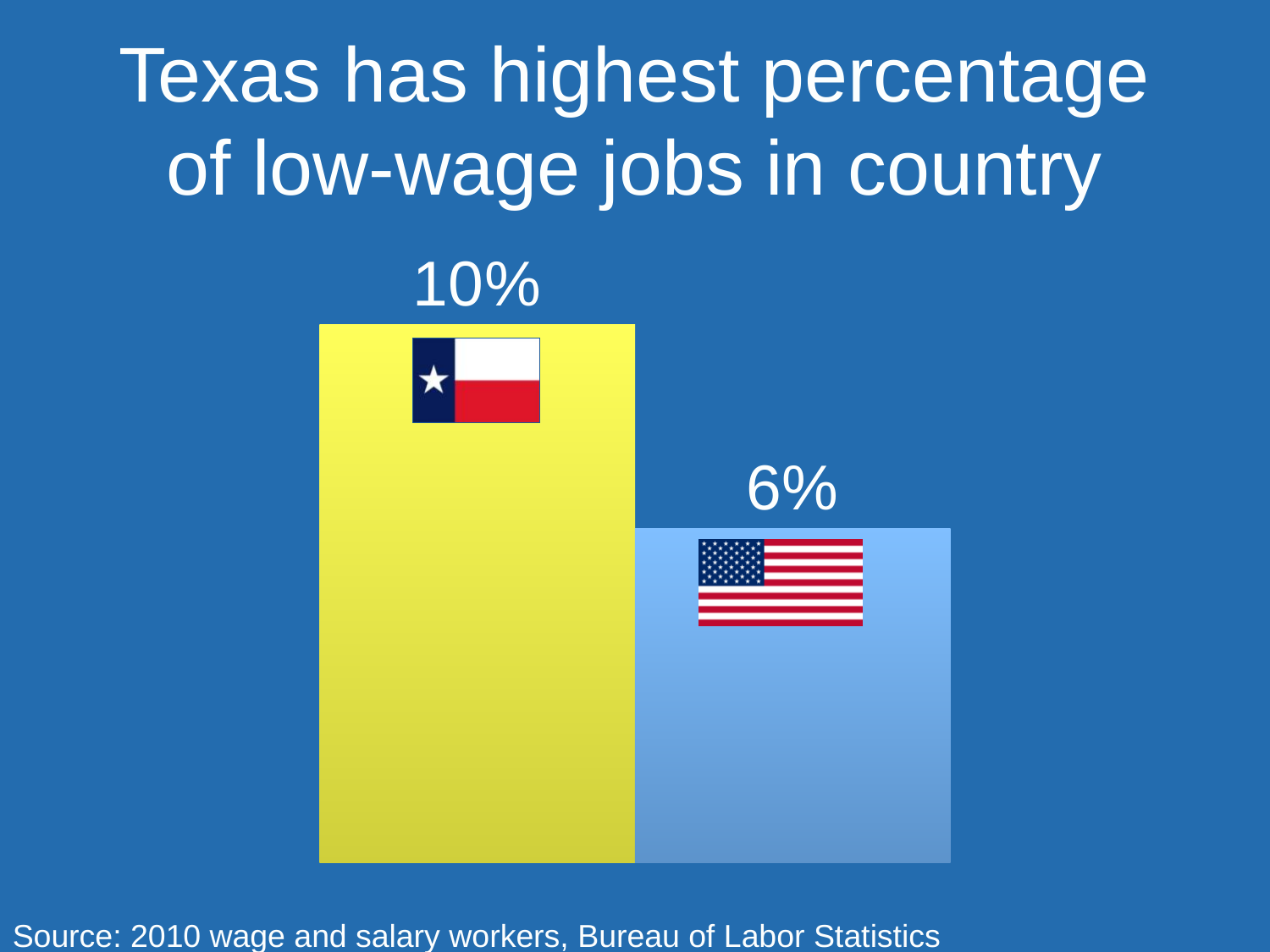
What percentage of low-wage jobs is shown for the United States as a whole? 6% What kind of chart is shown on the slide? bar chart What is the title of the slide? Texas has highest percentage of low-wage jobs in country Which bar is higher, Texas or the United States? Texas What colour is the Texas bar? yellow What is the difference in percentage points between the Texas bar and the United States bar? 4 percentage points What is the source cited for the chart data? 2010 wage and salary workers, Bureau of Labor Statistics Is the value for Texas larger or smaller than the value for the United States? larger What percentage of low-wage jobs is shown for Texas? 10% Which bar is lower, Texas or the United States? United States How many bars are shown on the chart? 2